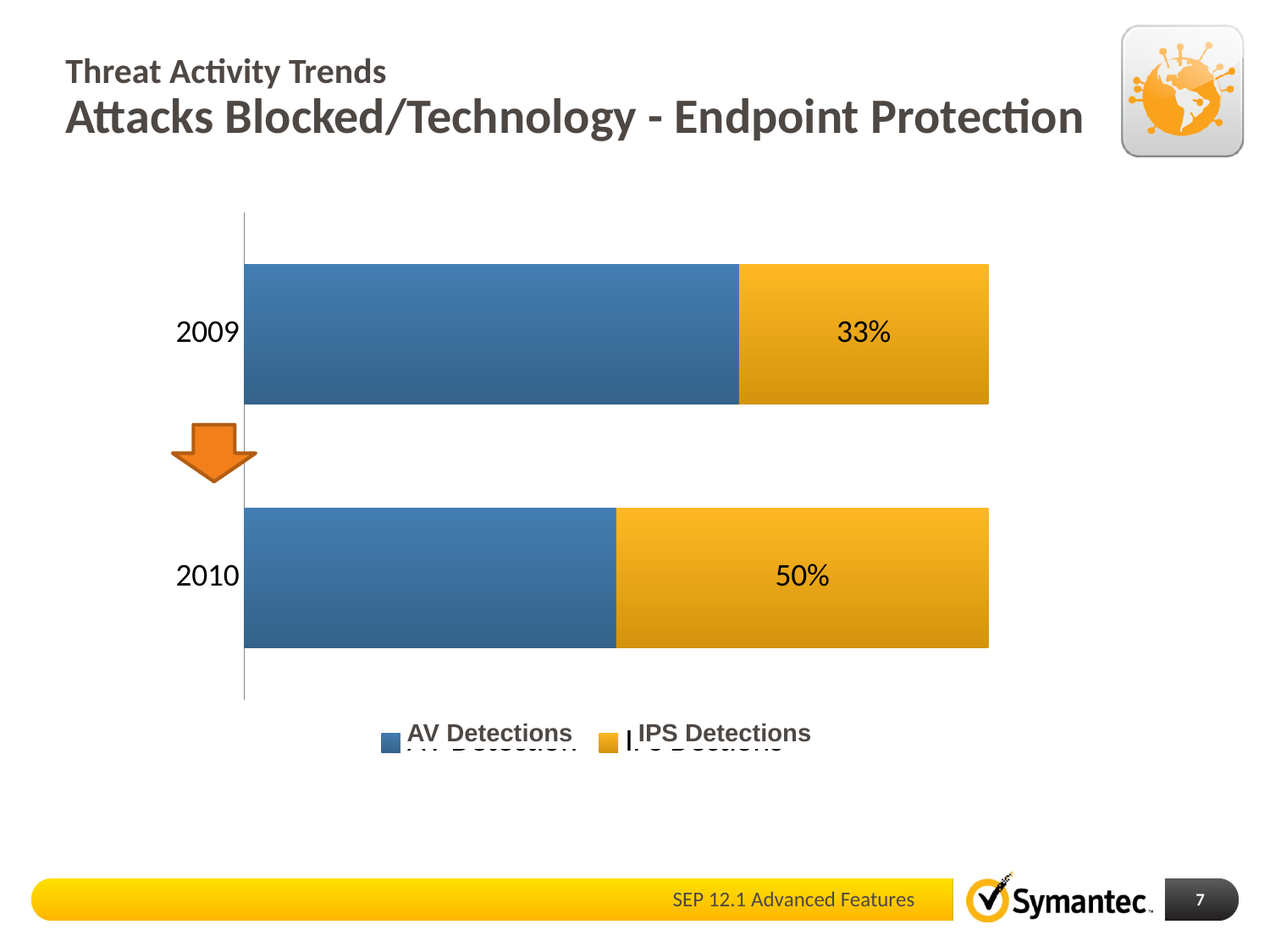
Which colour represents IPS Detections in the chart? orange Which year has the higher IPS Detections share? 2010 Is the IPS Detections value larger in 2009 or in 2010? 2010 What is the difference between the IPS Detections values for 2010 and 2009? 17% Does the IPS Detections share rise or fall from 2009 to 2010? rise What is the IPS Detections value for 2009? 33% How many series does the legend list? 2 What is the IPS Detections value for 2010? 50% Which year has the lower IPS Detections share? 2009 In 2009, which segment is larger, AV Detections or IPS Detections? AV Detections How many years are shown in the chart? 2 What kind of chart is shown on the slide? stacked bar chart